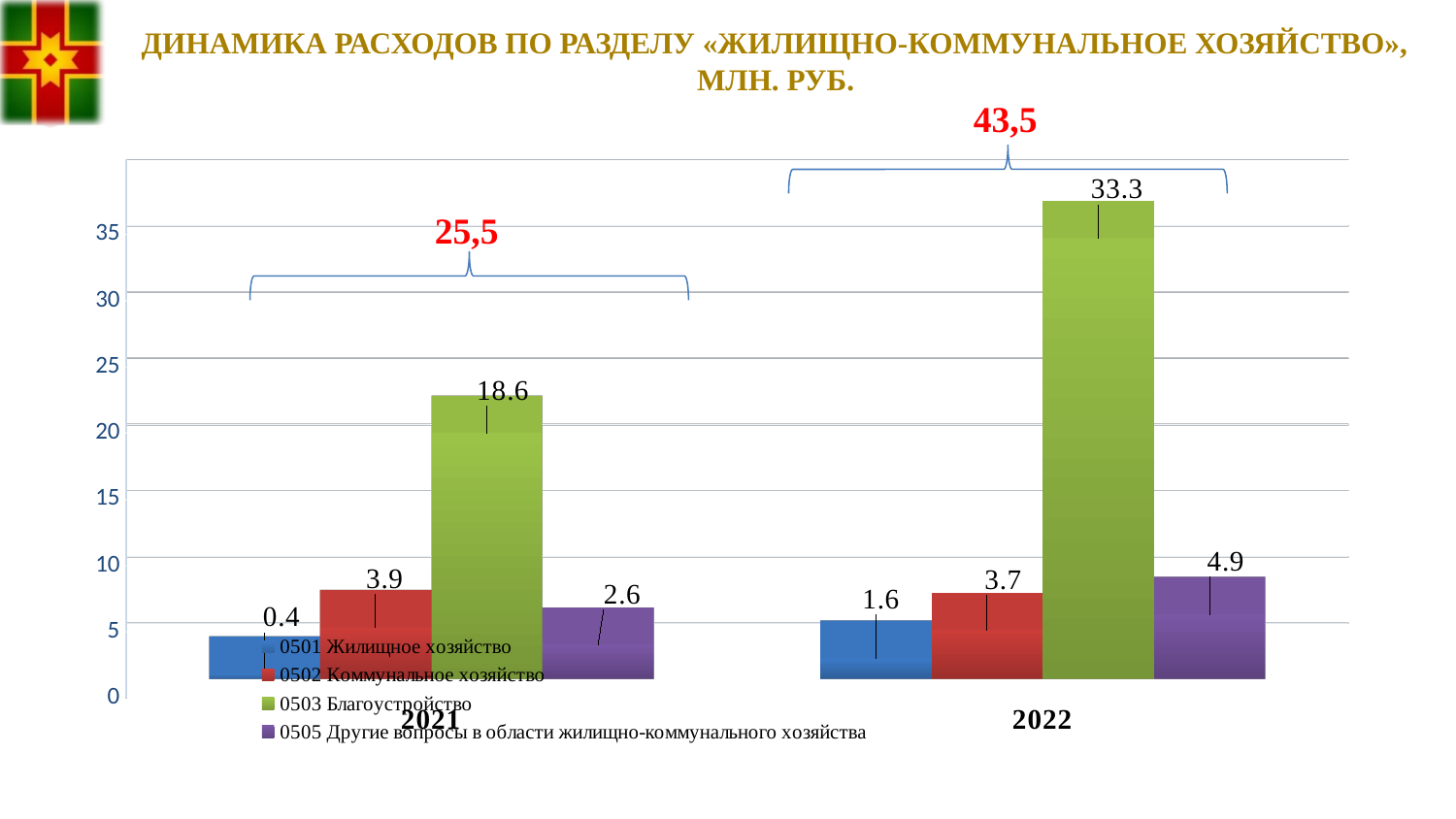
What is the value for 0505 Другие вопросы в области жилищно-коммунального хозяйства in 2022? 4.9 How many series does the legend list? 4 What type of chart is shown on the slide? bar chart What is the value for 0502 Коммунальное хозяйство in 2021? 3.9 Which series has the highest value in 2021? 0503 Благоустройство What is the value for 0501 Жилищное хозяйство in 2021? 0.4 What total is shown above the 2022 group of bars? 43,5 What is the difference between the 0503 Благоустройство values for 2022 and 2021? 14.7 Does the value for 0503 Благоустройство rise or fall from 2021 to 2022? rise Which is larger: 0502 Коммунальное хозяйство in 2021 or in 2022? 2021 What is the value for 0503 Благоустройство in 2022? 33.3 Which series has the lowest value in 2022? 0501 Жилищное хозяйство